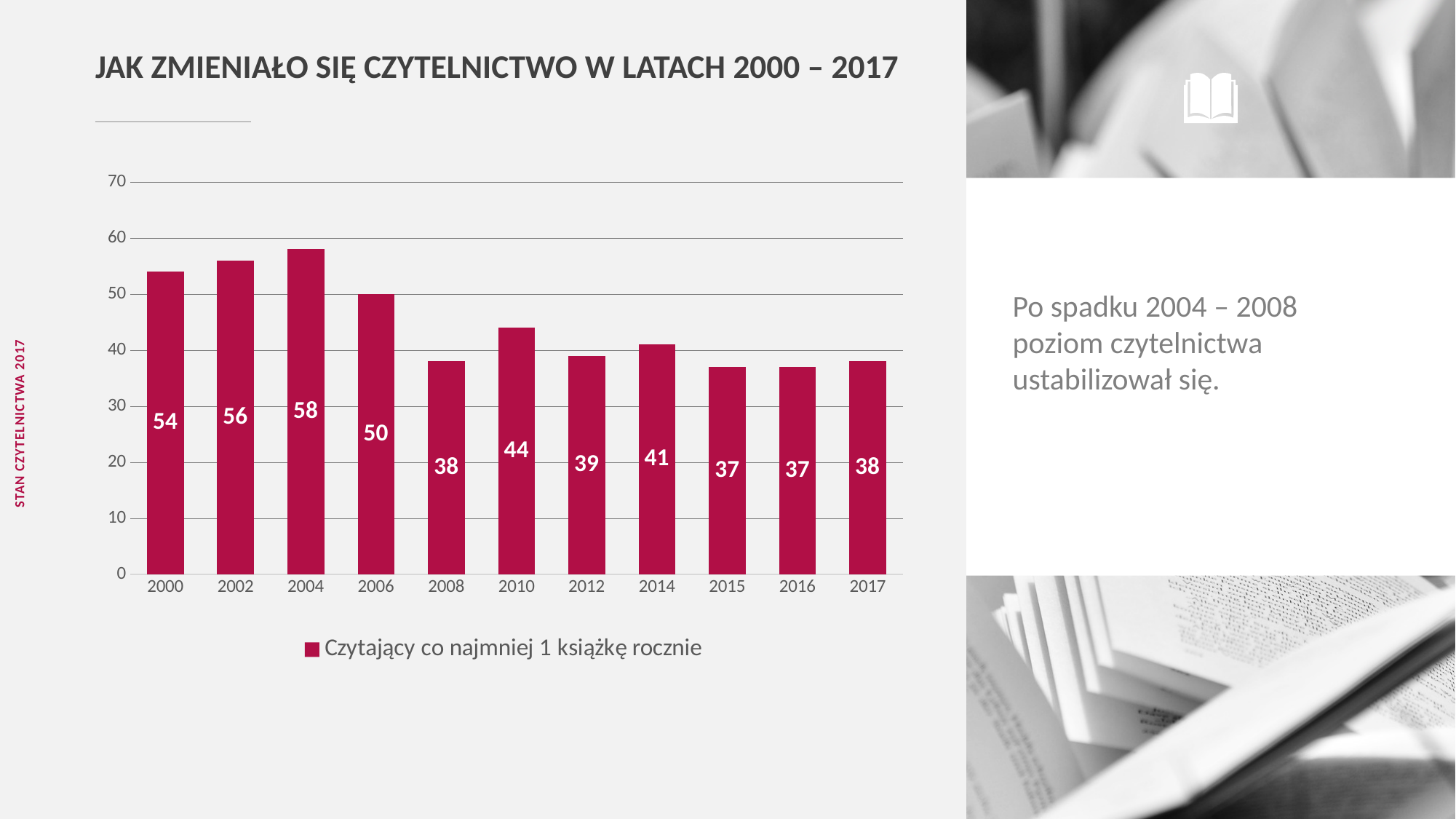
How many series does the legend list? 1 What is the value for 2010? 44 How many years are shown on the x axis? 11 What is the lowest value shown in the chart? 37 What is the value for 2017? 38 What kind of chart is shown on the slide? bar chart What is the legend entry for the series? Czytający co najmniej 1 książkę rocznie What is the value for 2004? 58 Which is larger, the value for 2000 or the value for 2006? 2000 Is the value for 2002 greater or less than 50? greater What is the difference between the values for 2004 and 2008? 20 Which year has the highest value? 2004